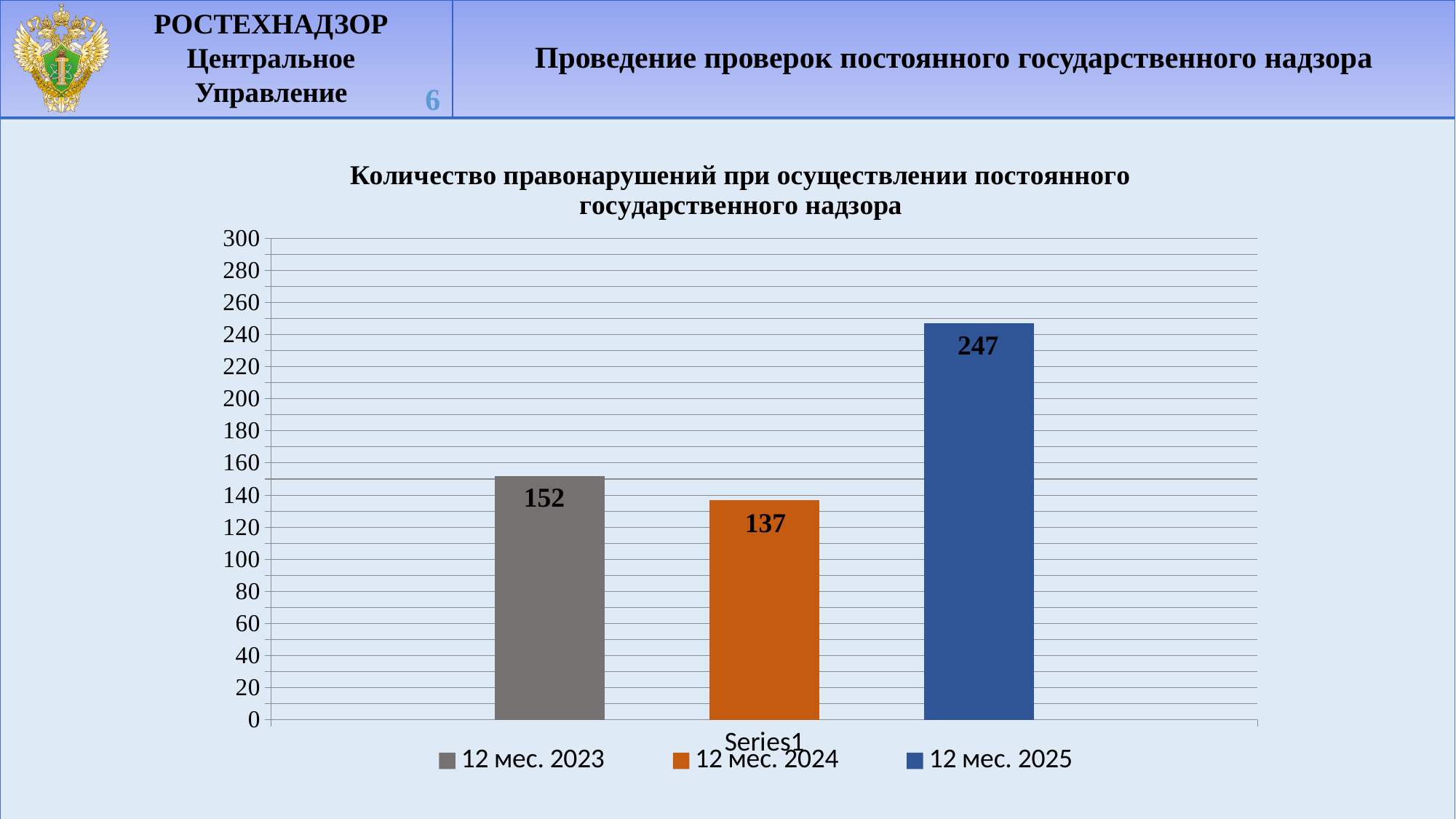
What is the title of the chart? Количество правонарушений при осуществлении постоянного государственного надзора What is the difference between the values for 12 мес. 2023 and 12 мес. 2024? 15 What is the value for 12 мес. 2024? 137 What is the value for 12 мес. 2023? 152 Which is larger, the value for 12 мес. 2023 or the value for 12 мес. 2024? 12 мес. 2023 Which series has the lowest value? 12 мес. 2024 What is the value for 12 мес. 2025? 247 Is the value for 12 мес. 2025 greater or less than 200? greater How many series does the legend list? 3 What kind of chart is shown on the slide? bar chart What is the difference between the values for 12 мес. 2025 and 12 мес. 2023? 95 Which series has the highest value? 12 мес. 2025